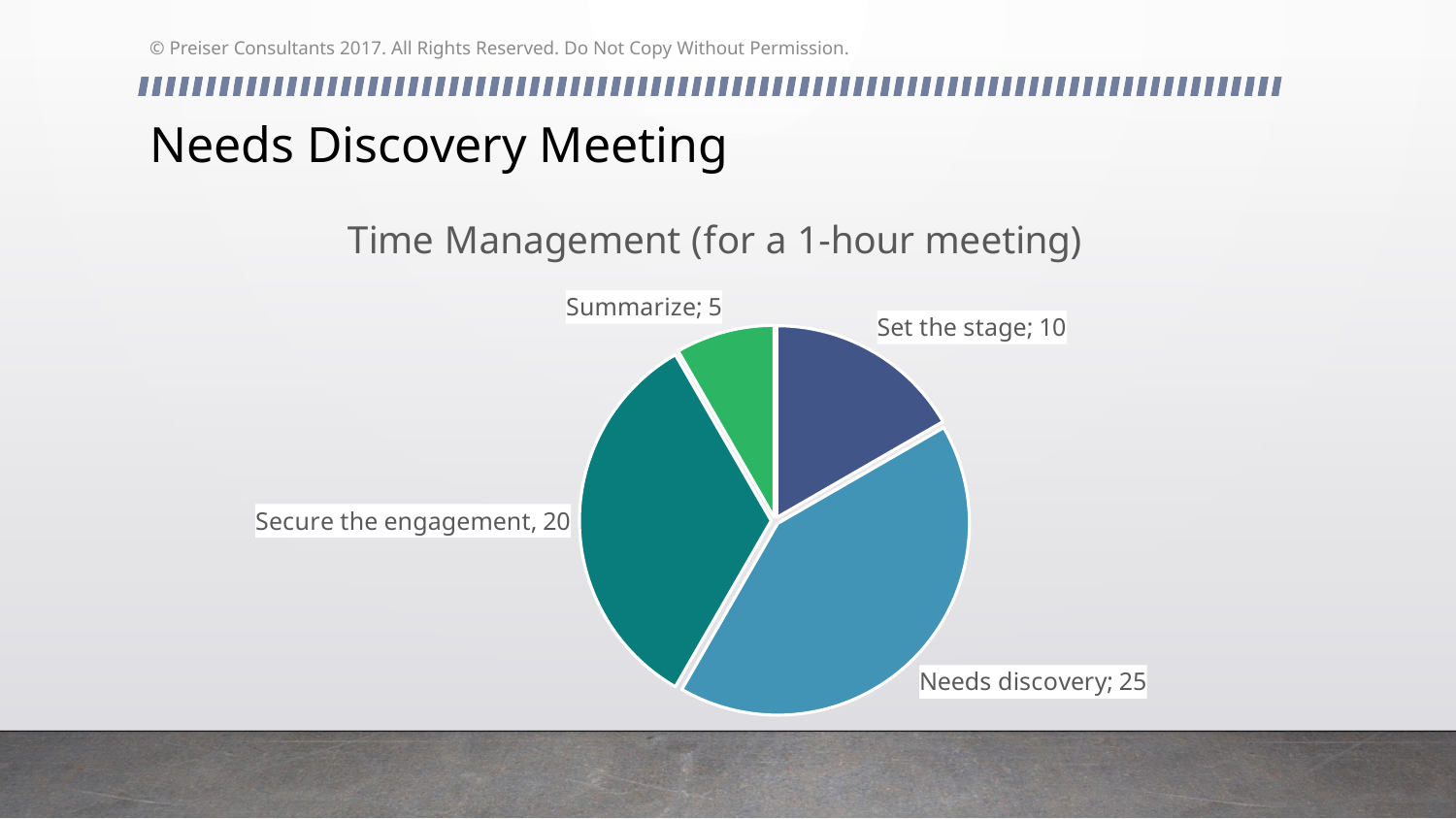
What type of chart is shown on the slide? pie chart What is the value for Summarize? 5 What is the value for Set the stage? 10 What is the title of the chart? Time Management (for a 1-hour meeting) What is the difference between the values for Needs discovery and Secure the engagement? 5 Which category has the smallest slice? Summarize What is the value for Secure the engagement? 20 How many slices does the pie chart have? 4 Which is larger, Set the stage or Secure the engagement? Secure the engagement What is the value for Needs discovery? 25 Which category has the largest slice? Needs discovery